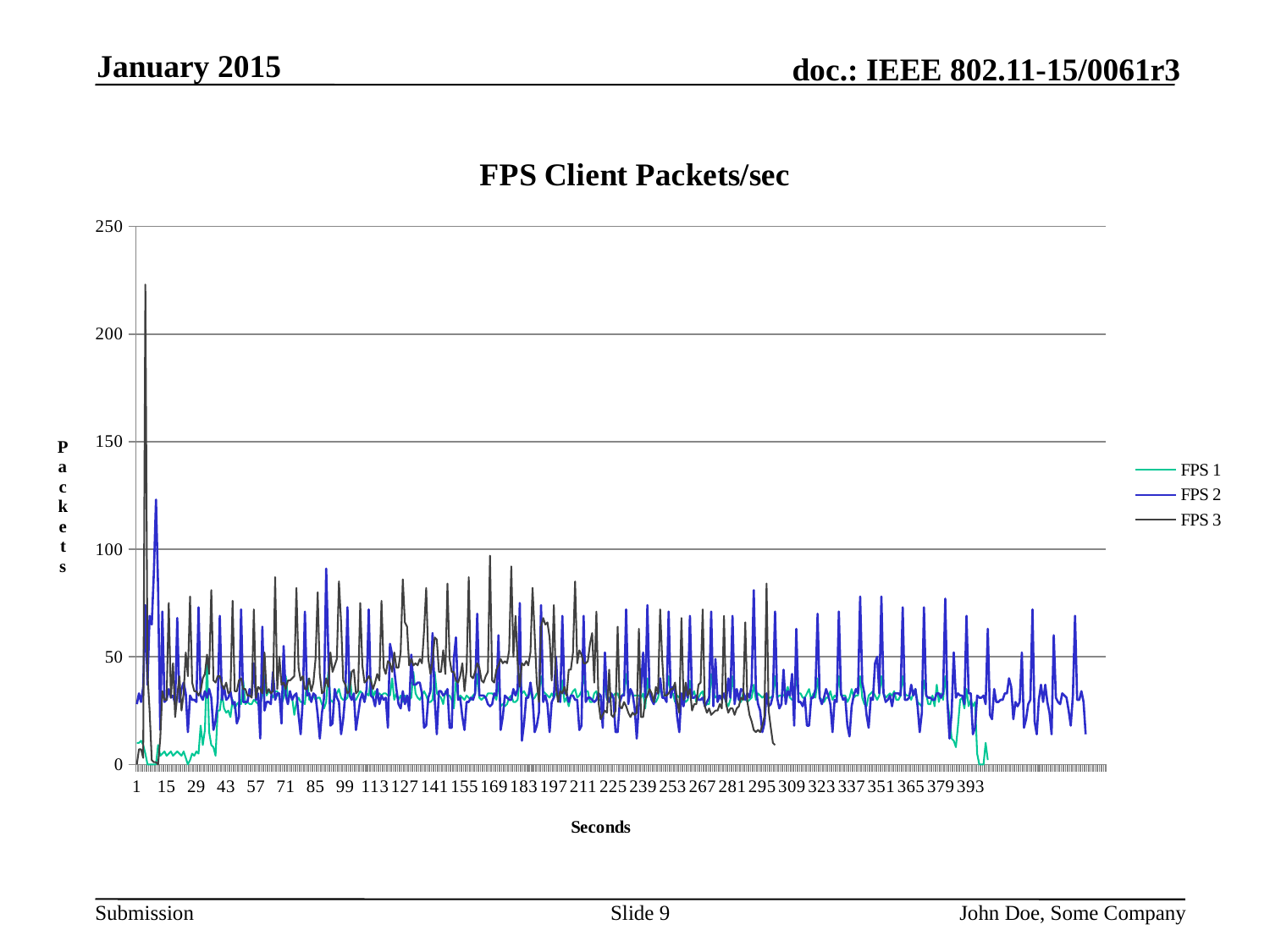
Is the highest peak of the FPS 2 series greater or less than 150? less Which series reaches the highest peak value on the chart? FPS 3 What kind of chart is shown on the slide? line chart Which series has the lowest values at the start of the chart (around second 1 to 29)? FPS 1 Is the highest peak of the FPS 3 series greater or less than 200? greater Is the highest peak of the FPS 1 series greater or less than 100? less What is the label of the x axis? Seconds How many series does the legend list? 3 Which series has the higher peak value, FPS 1 or FPS 2? FPS 2 What is the maximum value shown on the y axis? 250 What is the title of the chart? FPS Client Packets/sec